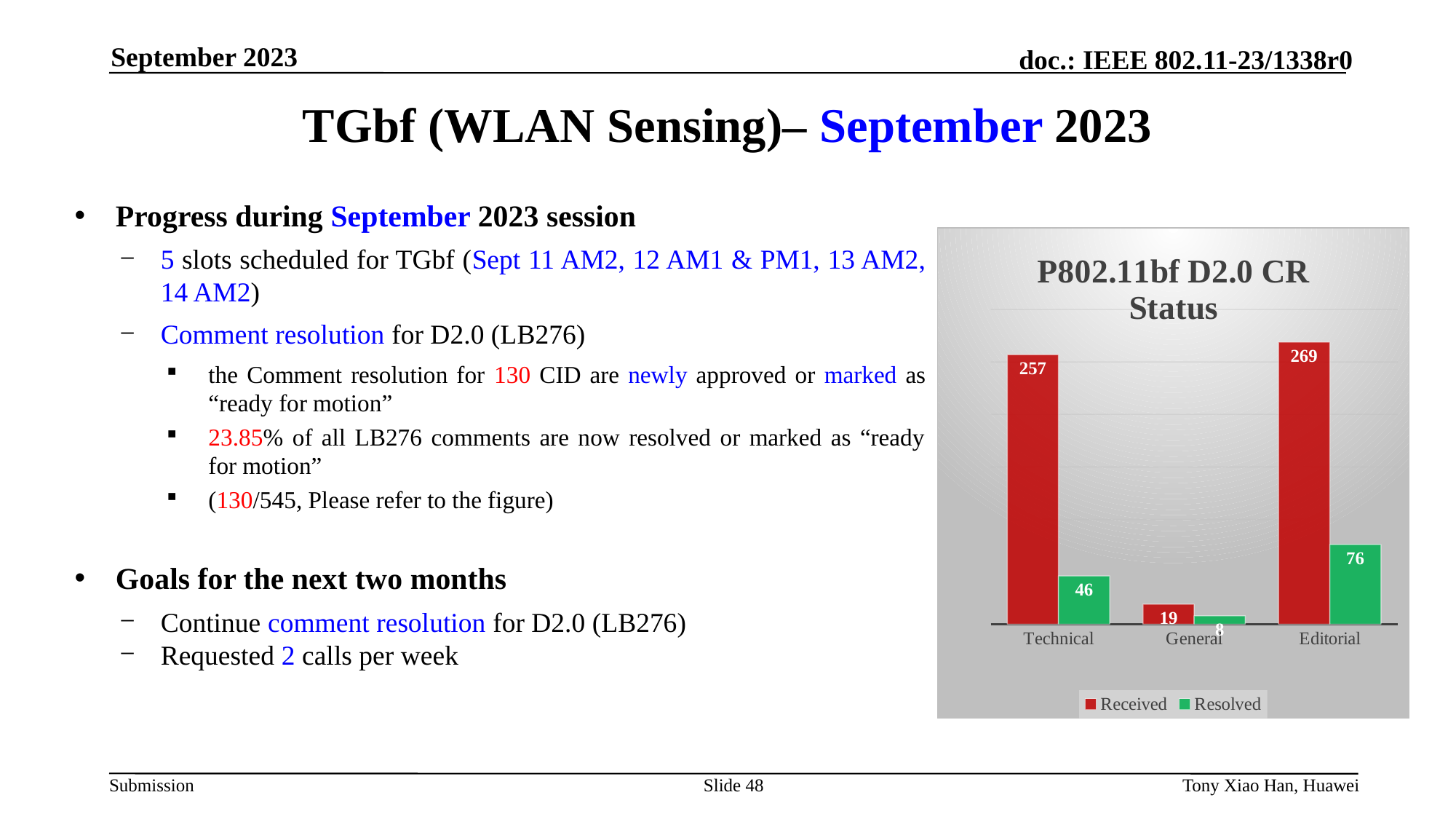
What type of chart is shown on the slide? bar chart What is the difference between the Received values for Editorial and Technical? 12 What is the Resolved value for Technical? 46 Which category has the lowest Resolved value? General How many categories are shown on the x axis of the chart? 3 What is the title of the chart? P802.11bf D2.0 CR Status What is the Resolved value for Editorial? 76 Which is larger, the Resolved value for Editorial or the Resolved value for Technical? Editorial What is the Received value for General? 19 What is the Received value for Technical? 257 Which category has the highest Received value? Editorial How many series does the chart legend list? 2